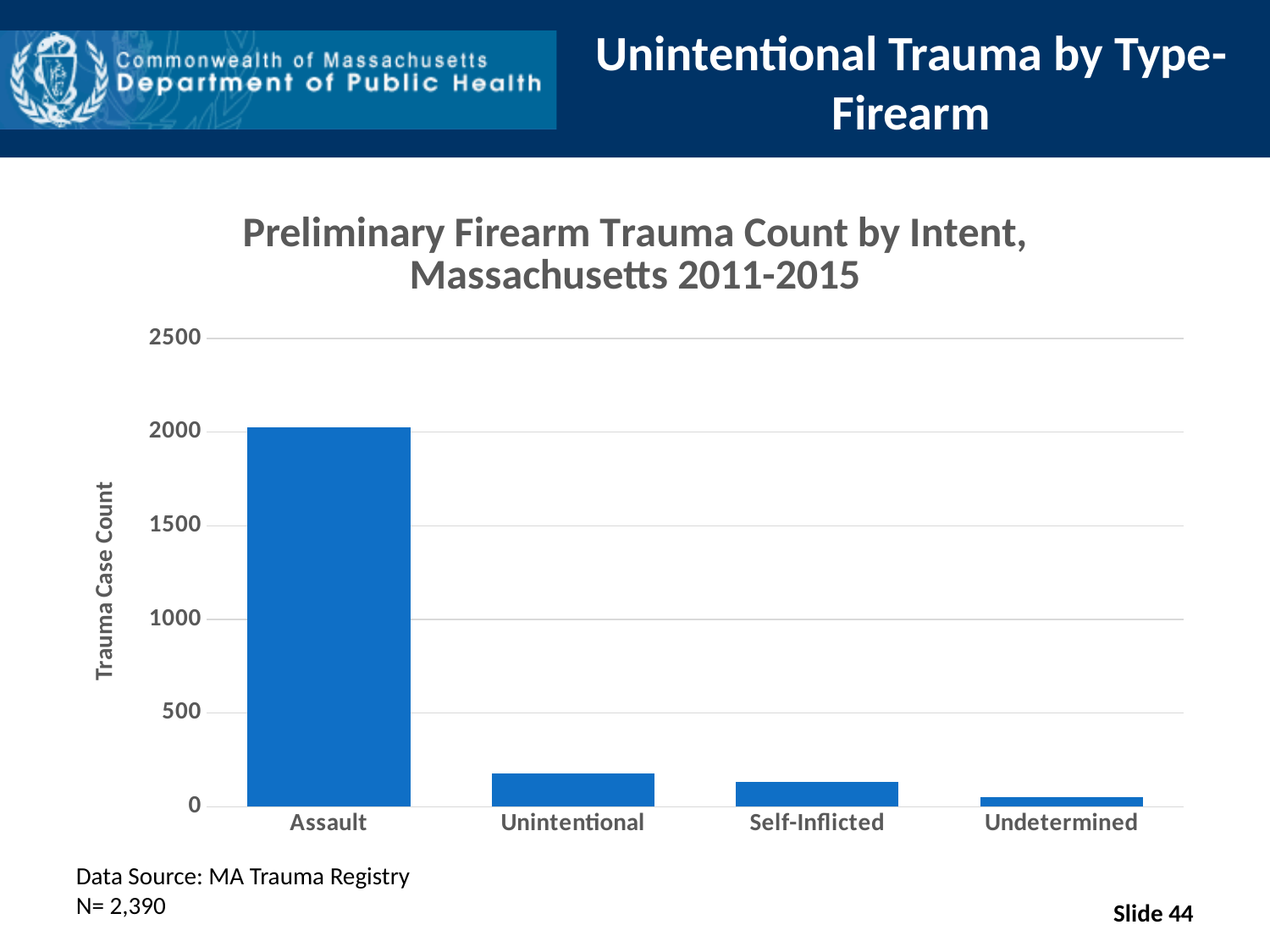
What kind of chart is shown on the slide? bar chart Which is larger, the value for Self-Inflicted or the value for Undetermined? Self-Inflicted Which category has the highest trauma case count? Assault How many categories are shown on the x axis? 4 Is the value for Assault greater or less than 2500? less What is the label of the y axis? Trauma Case Count What is the title of the chart? Preliminary Firearm Trauma Count by Intent, Massachusetts 2011-2015 Is the value for Self-Inflicted greater or less than 500? less Is the value for Unintentional greater or less than 500? less Which category has the lowest trauma case count? Undetermined Which is larger, the value for Unintentional or the value for Self-Inflicted? Unintentional